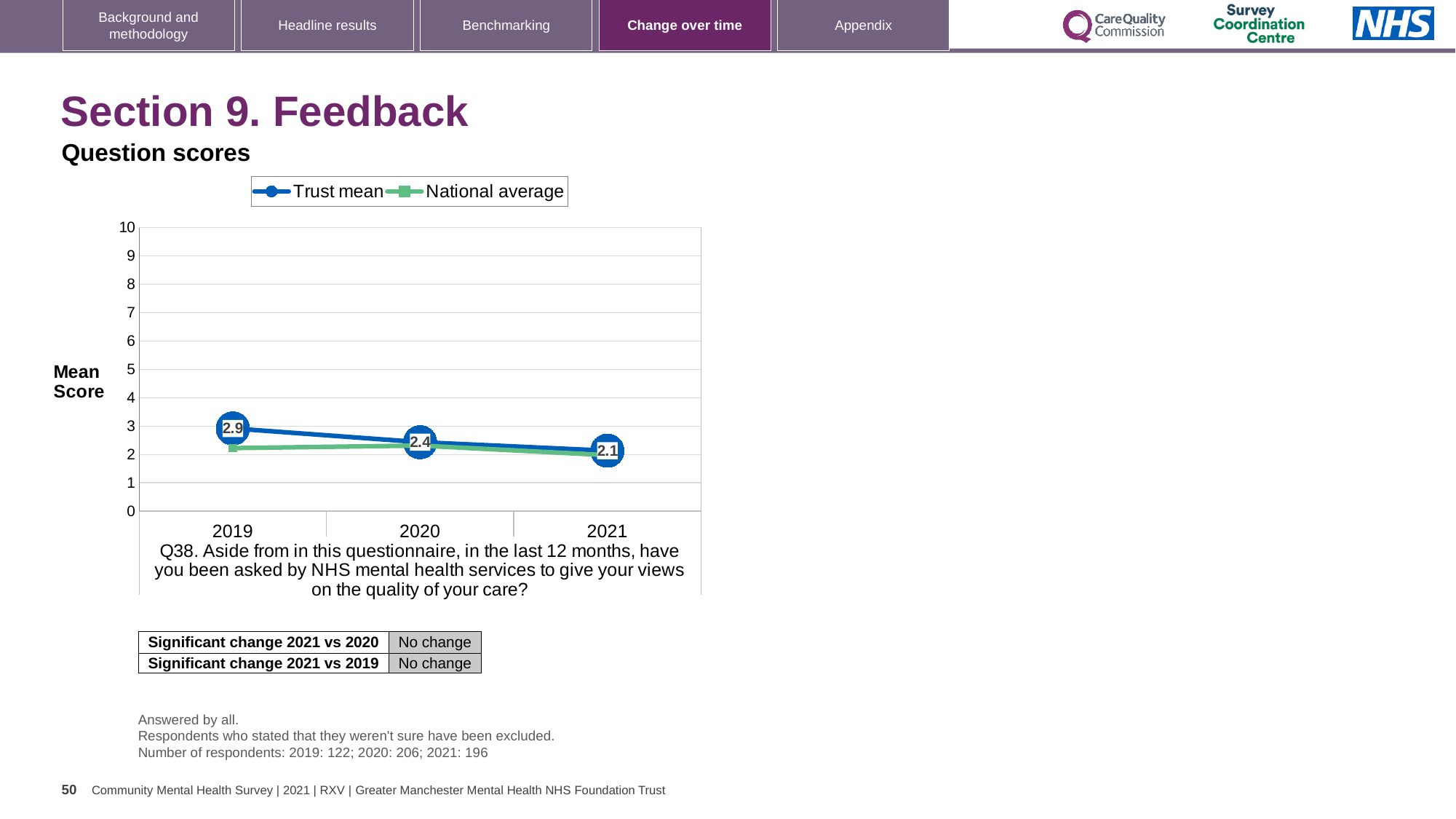
What kind of chart is shown on the slide? line chart What is the Trust mean score for 2020? 2.4 In which year is the Trust mean score highest? 2019 What is the difference between the Trust mean score in 2019 and in 2021? 0.8 How many years are plotted on the x axis? 3 In 2019, which is larger: the Trust mean or the National average? Trust mean What is the Trust mean score for 2021? 2.1 Is the National average for 2020 greater or less than 3? less How many series does the legend list? 2 In which year is the Trust mean score lowest? 2021 Does the Trust mean rise or fall from 2019 to 2021? fall What is the Trust mean score for 2019? 2.9